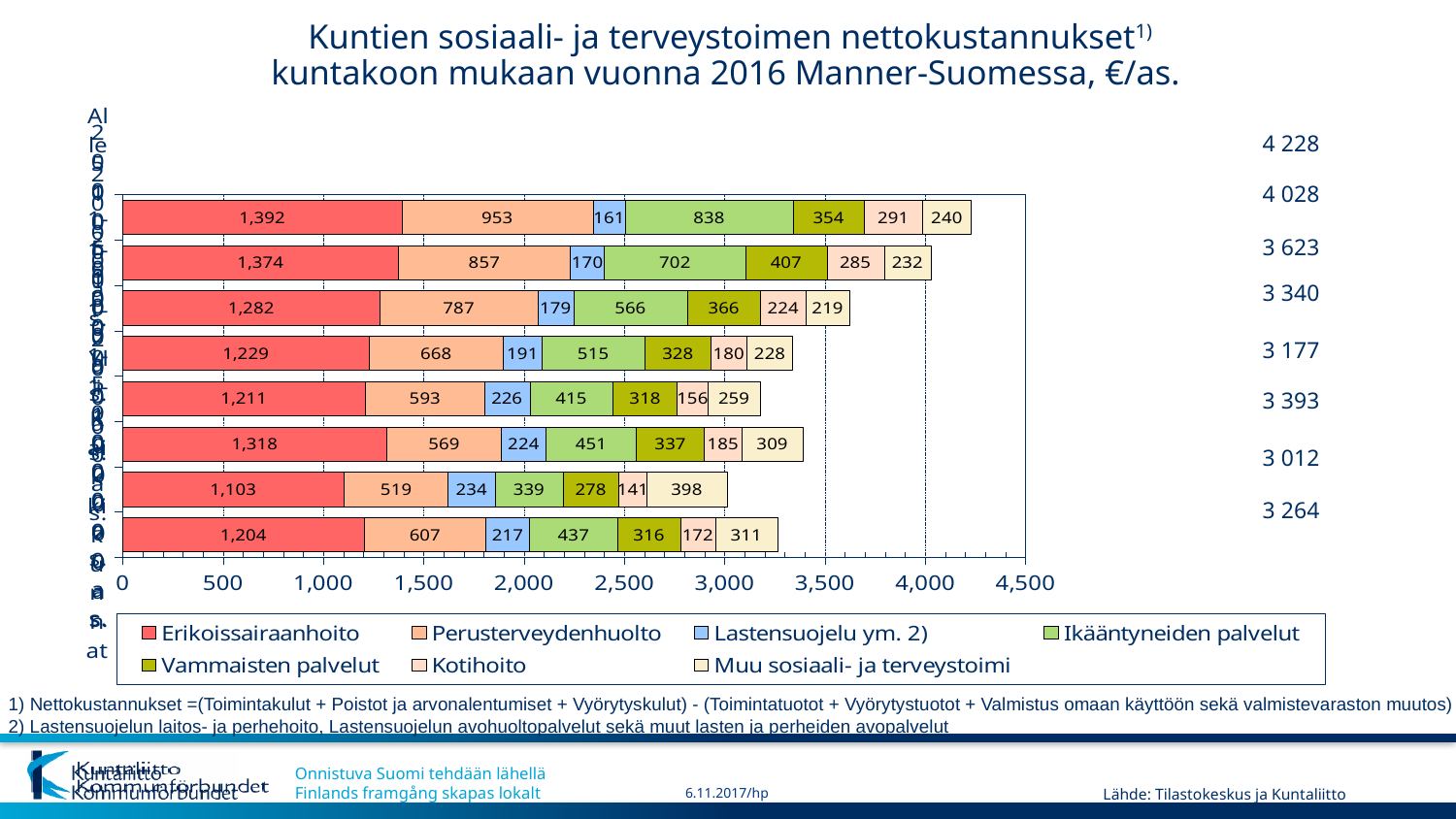
What total value is printed to the right of the top bar? 4 228 How many series does the legend list? 7 What is the Erikoissairaanhoito value in the top bar? 1,392 What is the Lastensuojelu ym. 2) value in the fifth bar from the top? 226 In the top bar, what is the difference between the Erikoissairaanhoito and Perusterveydenhuolto values? 439 Which is larger: the Muu sosiaali- ja terveystoimi value in the seventh bar from the top or in the bottom bar? The seventh bar (398) Is the total length of the bottom bar greater or less than 3,000? greater What is the Perusterveydenhuolto value in the bottom bar? 607 Which year does the chart title say the data is for? 2016 Which bar has the lowest Erikoissairaanhoito value? The seventh bar from the top (1,103) How many bars are plotted in the chart? 8 What kind of chart is shown on the slide? Stacked bar chart